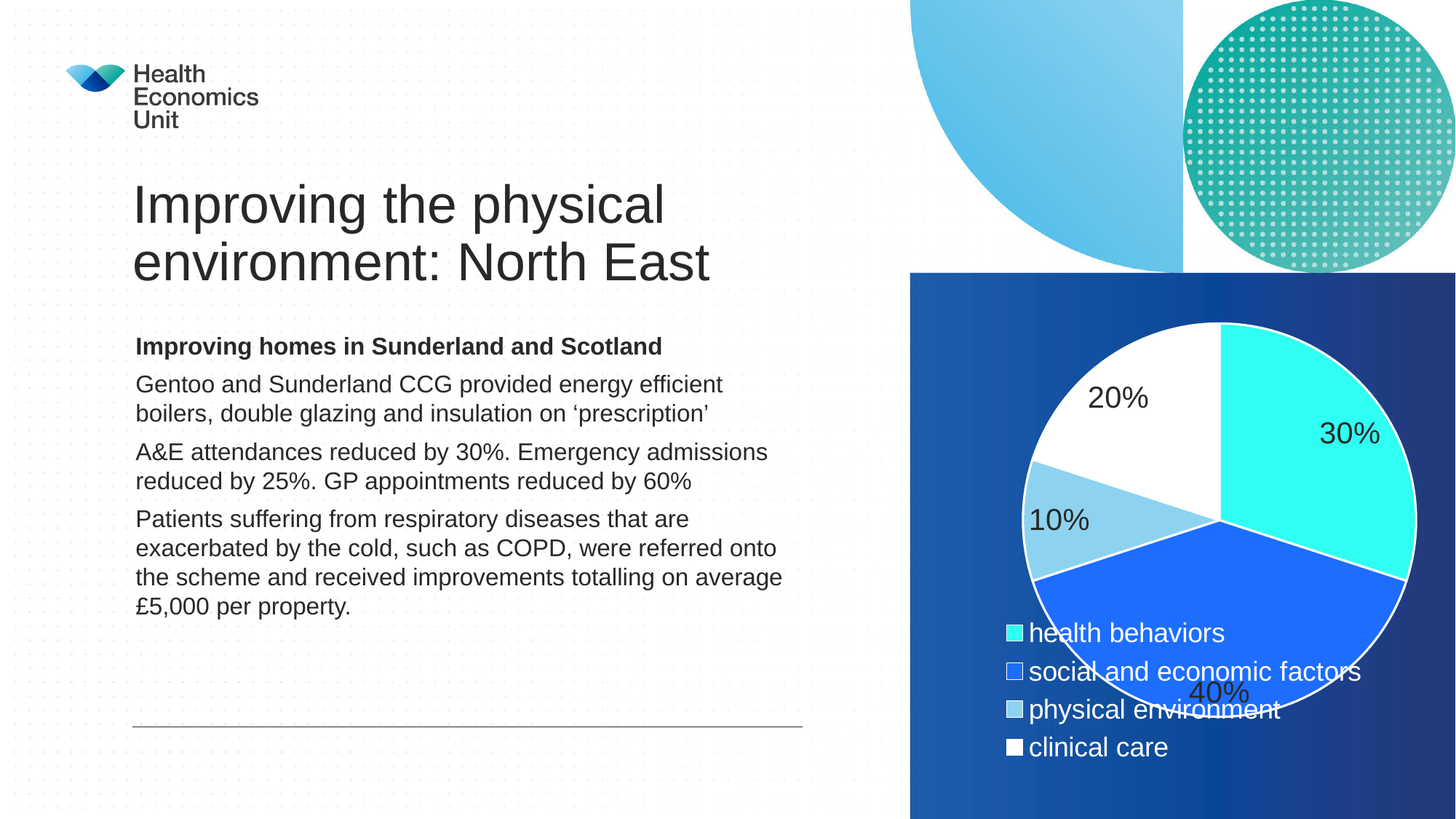
What kind of chart is shown on the slide? pie chart What share of the pie does physical environment take? 10% Which category has the smallest slice of the pie? physical environment What share of the pie does social and economic factors take? 40% What is the difference between the shares for social and economic factors and clinical care? 20% What colour is the slice for clinical care? white How many entries does the legend list? 4 What share of the pie does clinical care take? 20% Which category has the largest slice of the pie? social and economic factors What share of the pie does health behaviors take? 30% Which is larger, the share for health behaviors or the share for clinical care? health behaviors How many slices does the pie chart have? 4